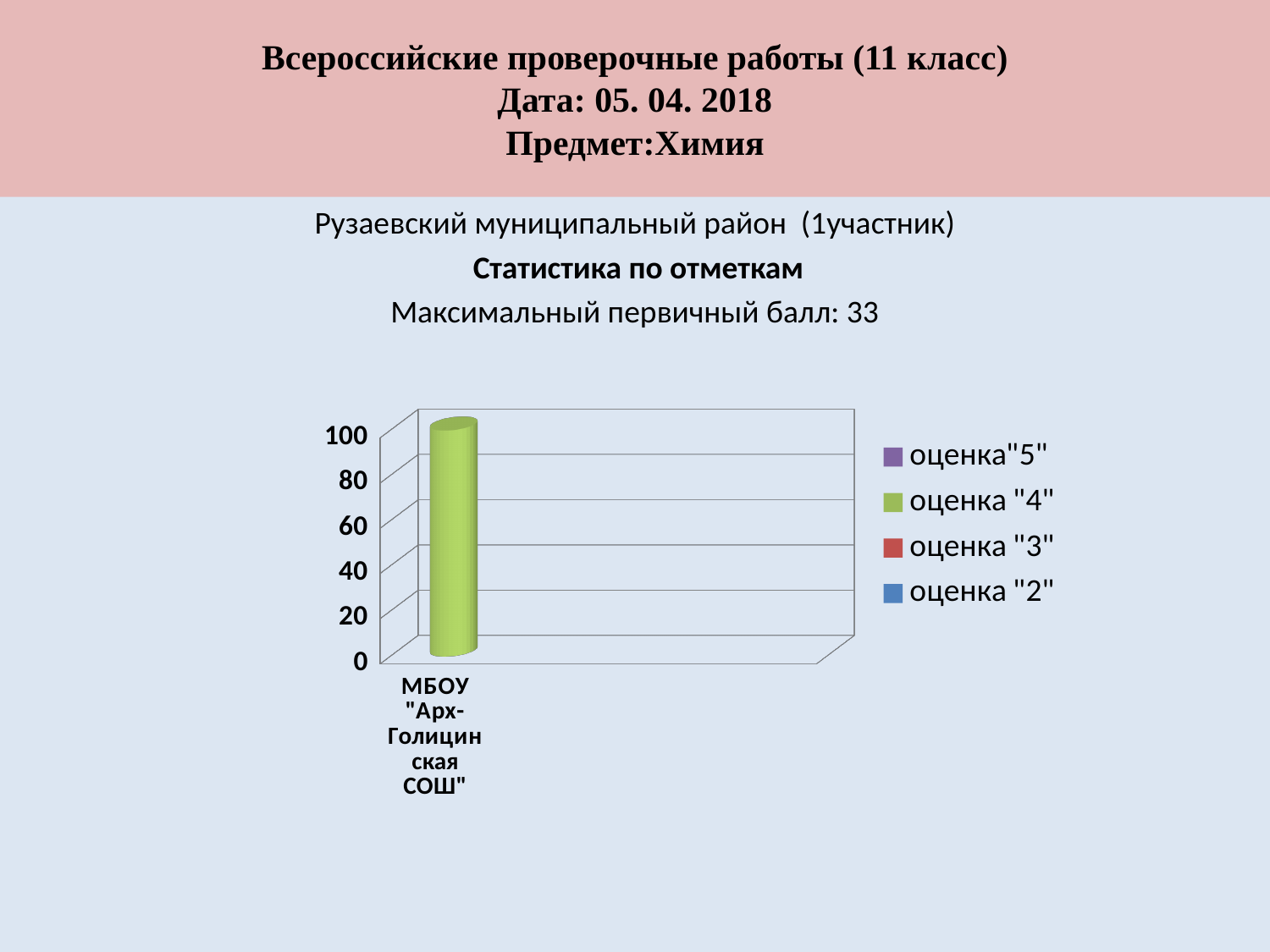
How many series does the chart legend list? 4 Which is larger, the value for оценка "4" or the value for оценка "3"? оценка "4" Which series has the highest value in the chart? оценка "4" What kind of chart is shown on the slide? bar chart What value does the bar for оценка "4" reach on the axis? 100 Which series is shown in green in the chart legend? оценка "4" Is the value for оценка "4" greater or less than 60? greater What is the name of the single category on the x axis? МБОУ "Арх-Голицинская СОШ" What is the highest tick value shown on the vertical axis of the chart? 100 How many categories are shown on the x axis of the chart? 1 Is the value for оценка "4" greater or less than 80? greater